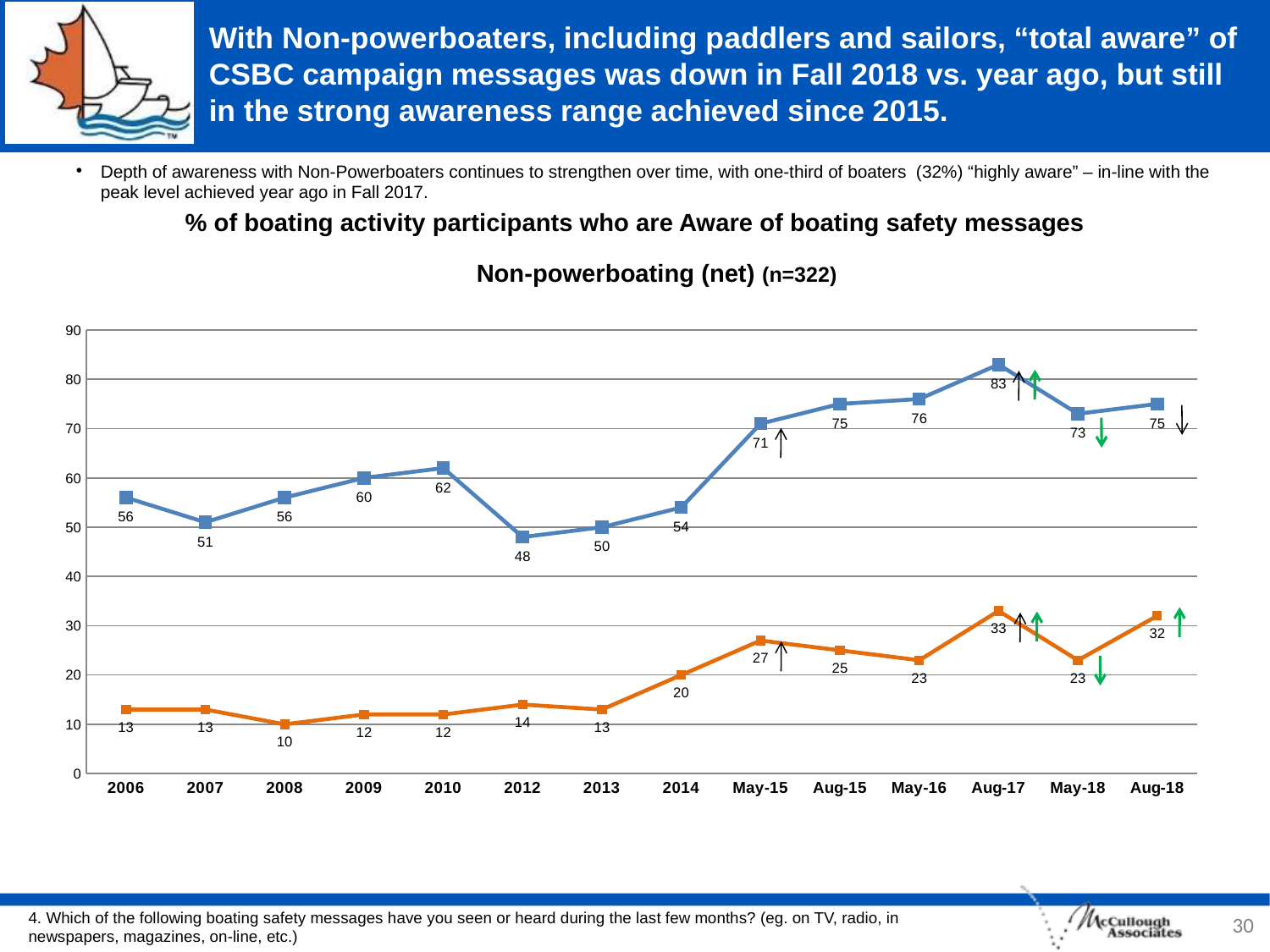
What is the sample size (n) shown in the chart subtitle? n=322 What is the difference between the orange line values for Aug-18 and May-18? 9 In which period does the blue line reach its highest value? Aug-17 What is the value of the orange line for Aug-18? 32 What is the value of the blue line for Aug-17? 83 Which is larger for the blue line: the value for 2010 or the value for 2014? 2010 What is the value of the blue line for 2012? 48 What type of chart is shown on the slide? Line chart Does the blue line rise or fall between 2014 and May-15? Rise How many time periods are shown on the x axis? 14 In which period does the orange line have its lowest value? 2008 What is the difference between the blue line values for Aug-17 and May-18? 10